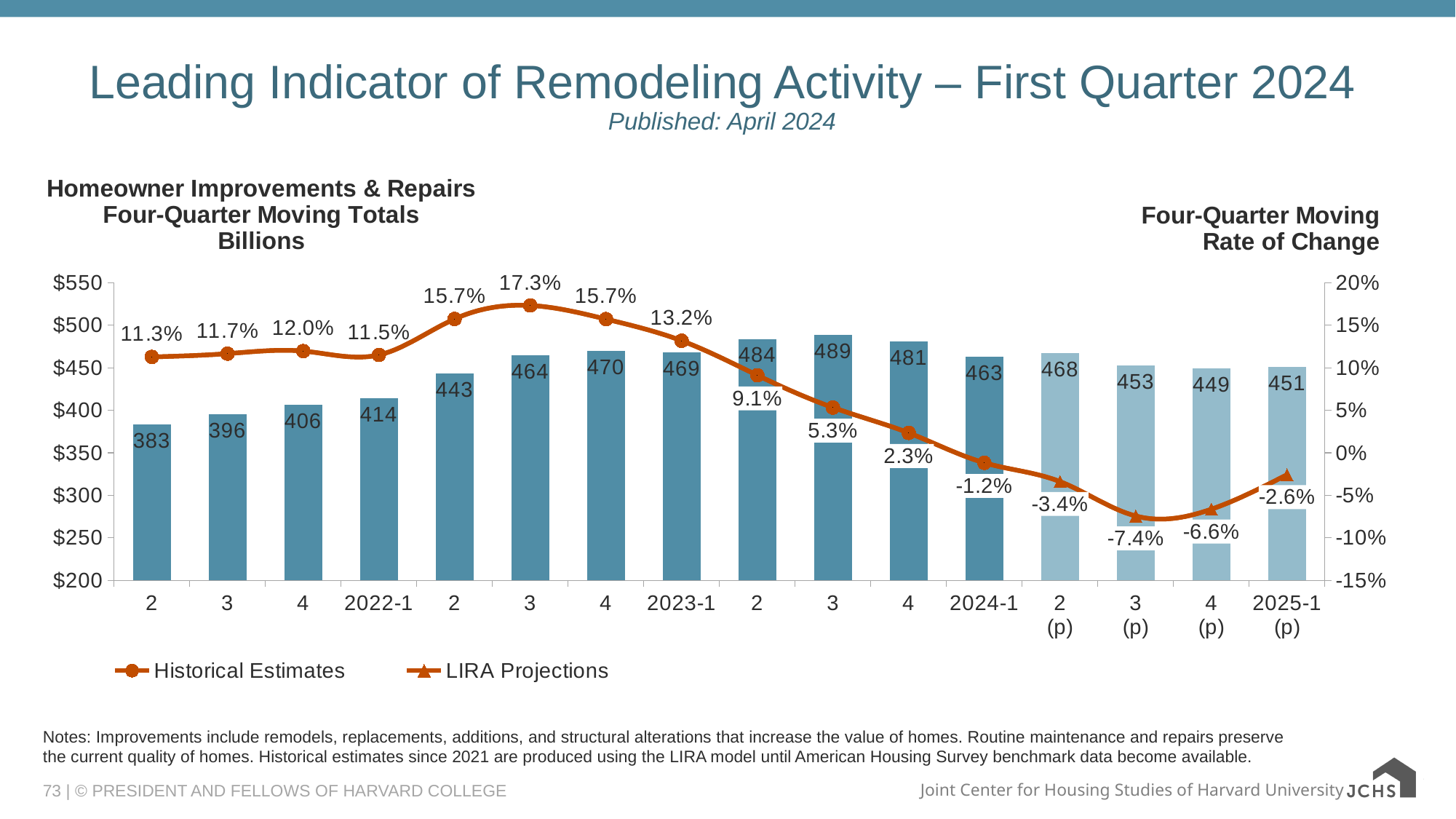
Which period has the lowest four-quarter moving rate of change on the line? 3 (p) How many series does the legend list? 2 Which is larger, the four-quarter moving total for 2023-1 or for 2024-1? 2023-1 What is the four-quarter moving total (billions) for 2023-1? 469 How many bars are plotted in the chart? 16 What is the projected four-quarter moving total for 2025-1 (p)? 451 What is the difference between the four-quarter moving totals for 2024-1 and 2022-1? 49 Does the four-quarter moving rate of change rise or fall from 2023-1 to 2024-1? Fall What is the highest four-quarter moving rate of change shown on the line? 17.3% What kind of chart is shown on the slide? Combined bar and line chart Which period has the highest four-quarter moving total bar? 3 (2023 Q3, 489) What is the four-quarter moving rate of change for 2024-1? -1.2%